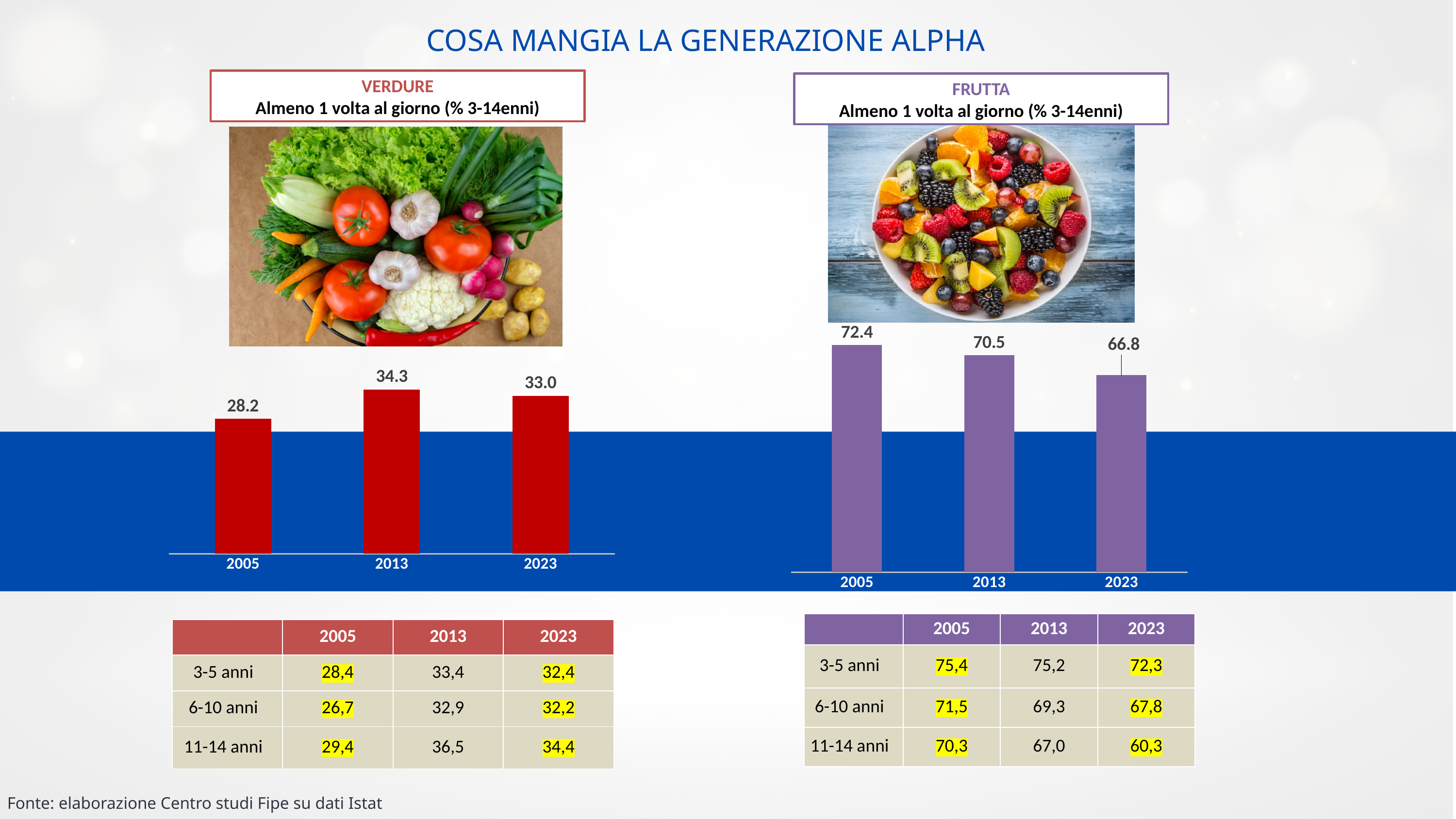
In the VERDURE chart, what is the value for 2005? 28.2 In the VERDURE chart, what is the difference between the 2013 and 2005 values? 6.1 In the VERDURE chart, what is the value for 2013? 34.3 In the FRUTTA chart, what is the value for 2005? 72.4 In the FRUTTA chart, is the value for 2013 larger or smaller than the value for 2023? larger In the FRUTTA chart, what is the difference between the 2005 and 2023 values? 5.6 In the FRUTTA chart, do the values rise or fall from 2005 to 2023? fall How many years are shown in the VERDURE chart? 3 In the FRUTTA chart, which year has the lowest value? 2023 In the VERDURE chart, which year has the highest value? 2013 In the FRUTTA chart, what is the value for 2023? 66.8 What type of chart is the FRUTTA chart? bar chart